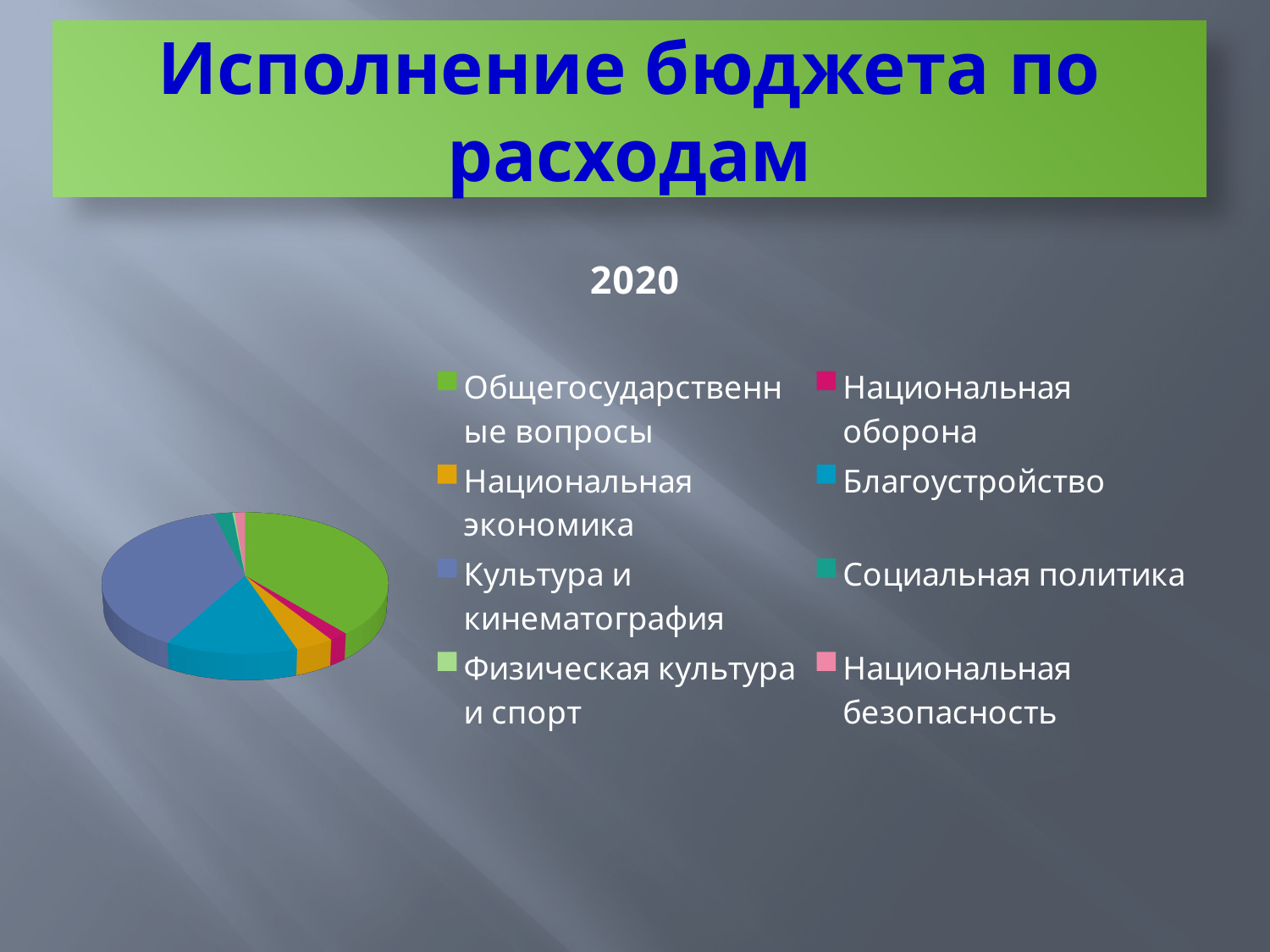
What colour is the slice for Благоустройство in the pie chart? blue (cyan) How many entries does the legend of the pie chart list? 8 Which slice is larger: Национальная экономика or Социальная политика? Национальная экономика Which slice is larger: Благоустройство or Национальная оборона? Благоустройство Which slice is larger: Общегосударственные вопросы or Национальная экономика? Общегосударственные вопросы What kind of chart is shown on the slide? pie chart What is the title of the pie chart? 2020